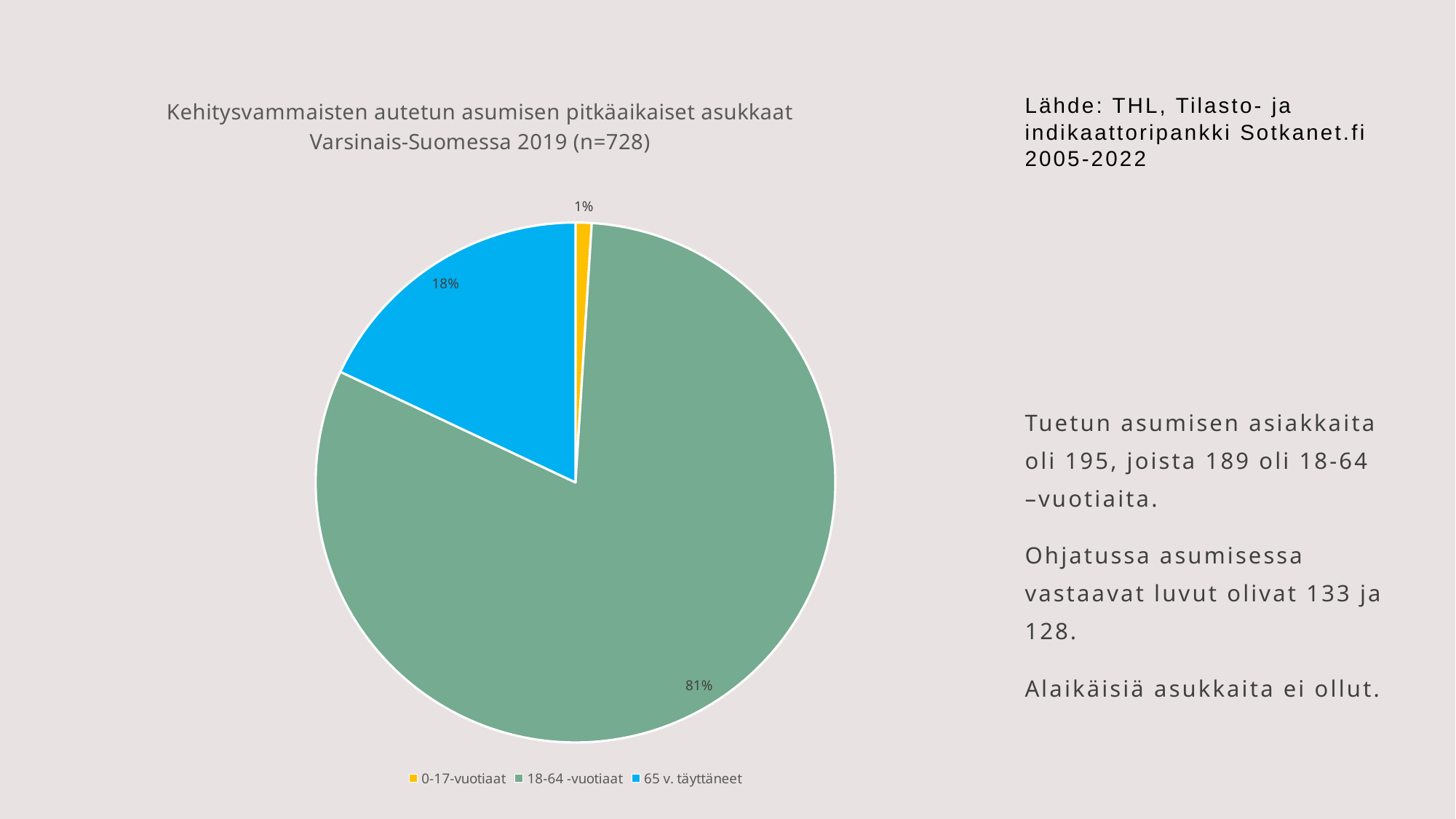
What share of the pie does the 65 v. täyttäneet slice represent? 18% What share of the pie does the 18-64 -vuotiaat slice represent? 81% Which category has the smallest slice of the pie? 0-17-vuotiaat What is the title of the chart? Kehitysvammaisten autetun asumisen pitkäaikaiset asukkaat Varsinais-Suomessa 2019 (n=728) What colour is the 65 v. täyttäneet slice? Blue What is the combined share of the 65 v. täyttäneet and 0-17-vuotiaat slices? 19% What share of the pie does the 0-17-vuotiaat slice represent? 1% What is the difference in percentage points between the 18-64 -vuotiaat slice and the 65 v. täyttäneet slice? 63 How many categories does the pie chart show? 3 Which slice is larger, 65 v. täyttäneet or 0-17-vuotiaat? 65 v. täyttäneet Which category has the largest slice of the pie? 18-64 -vuotiaat What kind of chart is shown on the slide? Pie chart